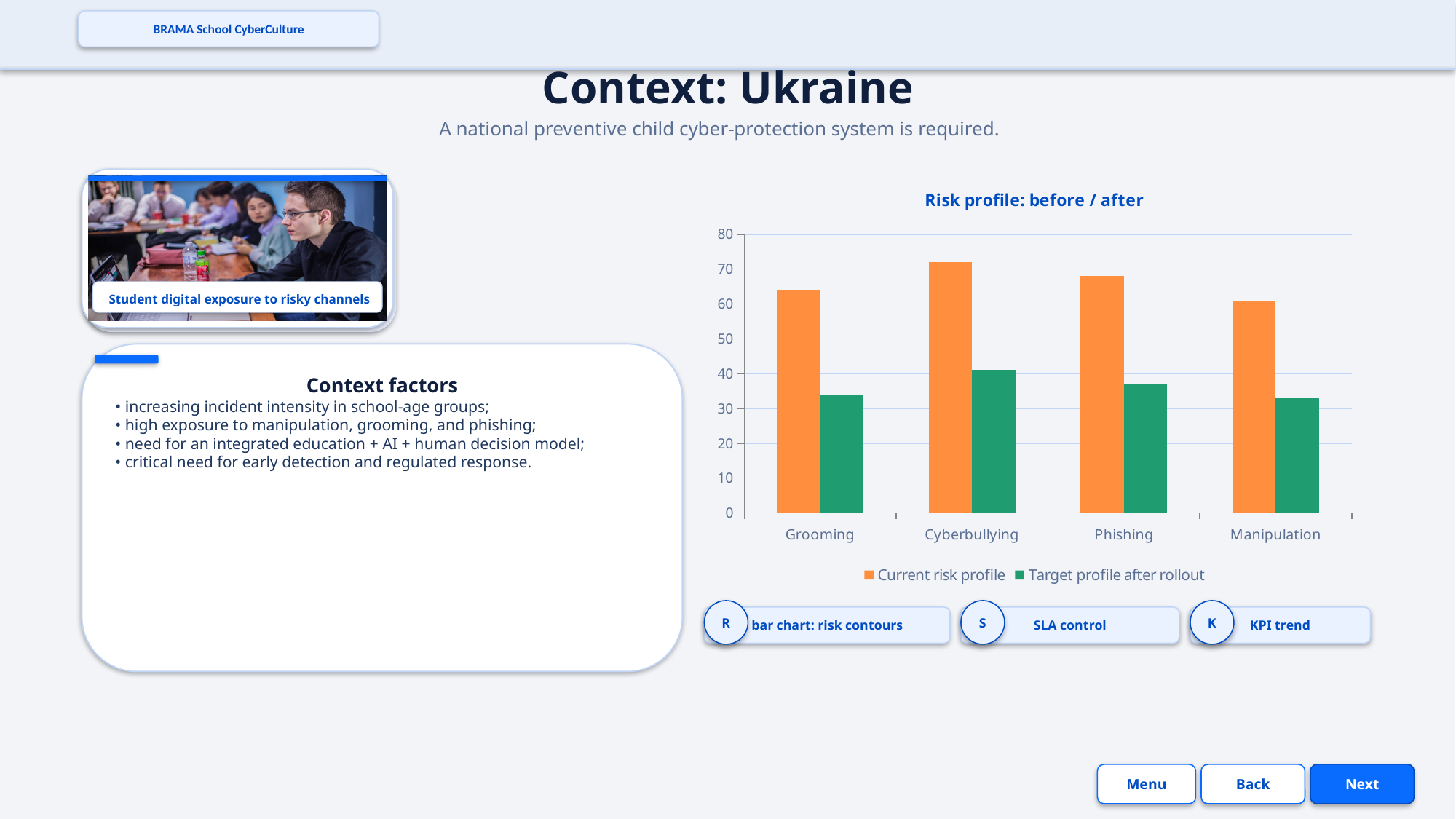
What colour are the bars for the Target profile after rollout series? green What type of chart is shown under the title "Risk profile: before / after"? bar chart Which is larger: the Current risk profile value for Cyberbullying or the Current risk profile value for Manipulation? Cyberbullying Is the Current risk profile value for Manipulation greater or less than 50? greater Which category has the highest value for the Current risk profile series? Cyberbullying How many categories are shown on the x axis of the "Risk profile: before / after" chart? 4 Is the Target profile after rollout value for Grooming greater or less than 40? less Is the Target profile after rollout value for Phishing greater or less than 30? greater Which category has the highest value for the Target profile after rollout series? Cyberbullying For Phishing, which series has the larger value: Current risk profile or Target profile after rollout? Current risk profile How many series does the legend of the "Risk profile: before / after" chart list? 2